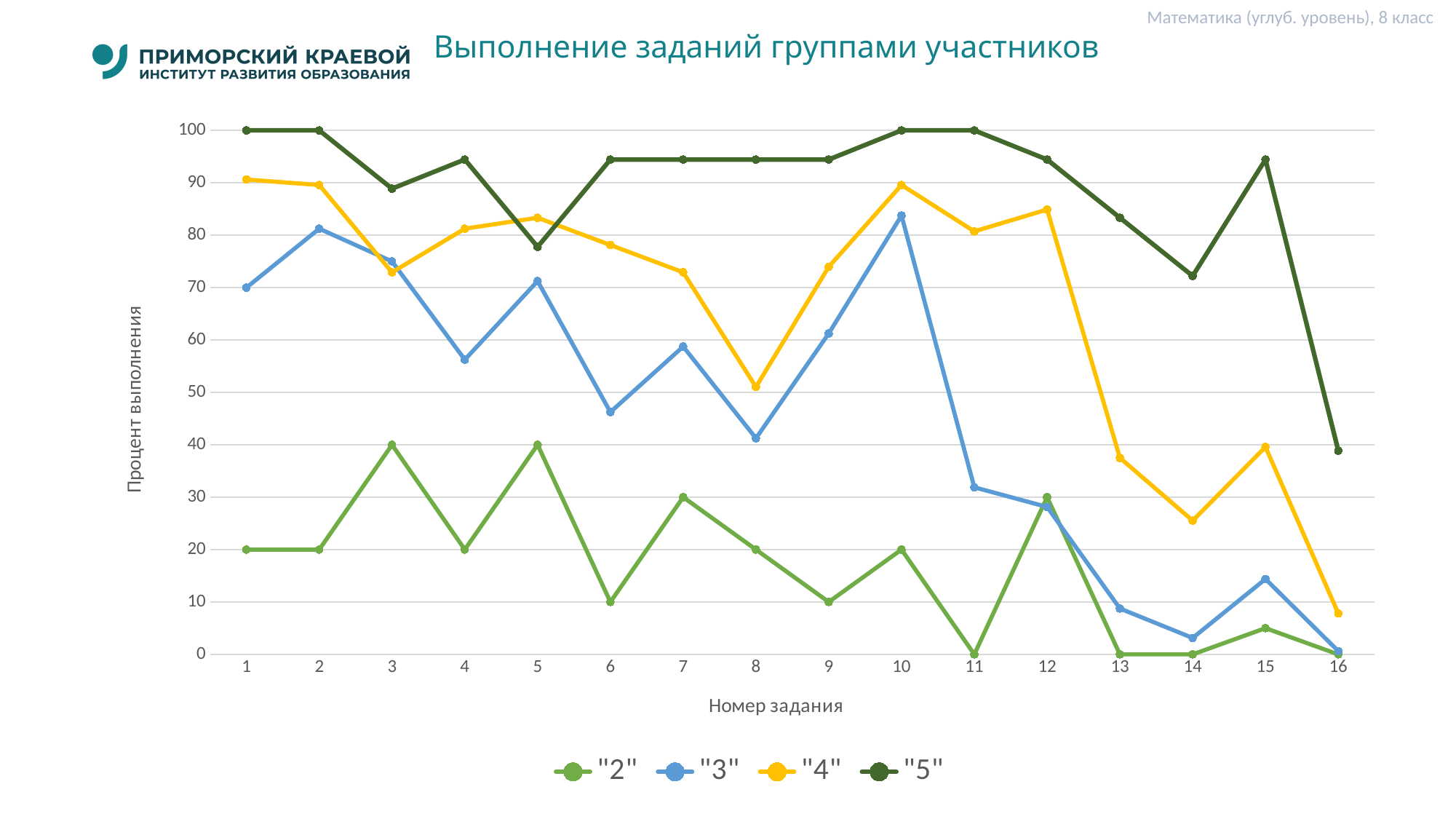
Which is larger at task 10: the value for series "3" or series "4"? "4" What is the value for series "2" at task 3? 40 What is the value for series "3" at task 1? 70 What is the title of the chart? Выполнение заданий группами участников Which series has the lowest value at task 1? "2" What kind of chart is shown on the slide? line chart How many task numbers are shown on the x axis? 16 Which series has the highest value at task 16? "5" Is the value for series "4" at task 13 greater or less than 40? less What is the value for series "5" at task 1? 100 What is the value for series "2" at task 11? 0 How many series does the legend list? 4